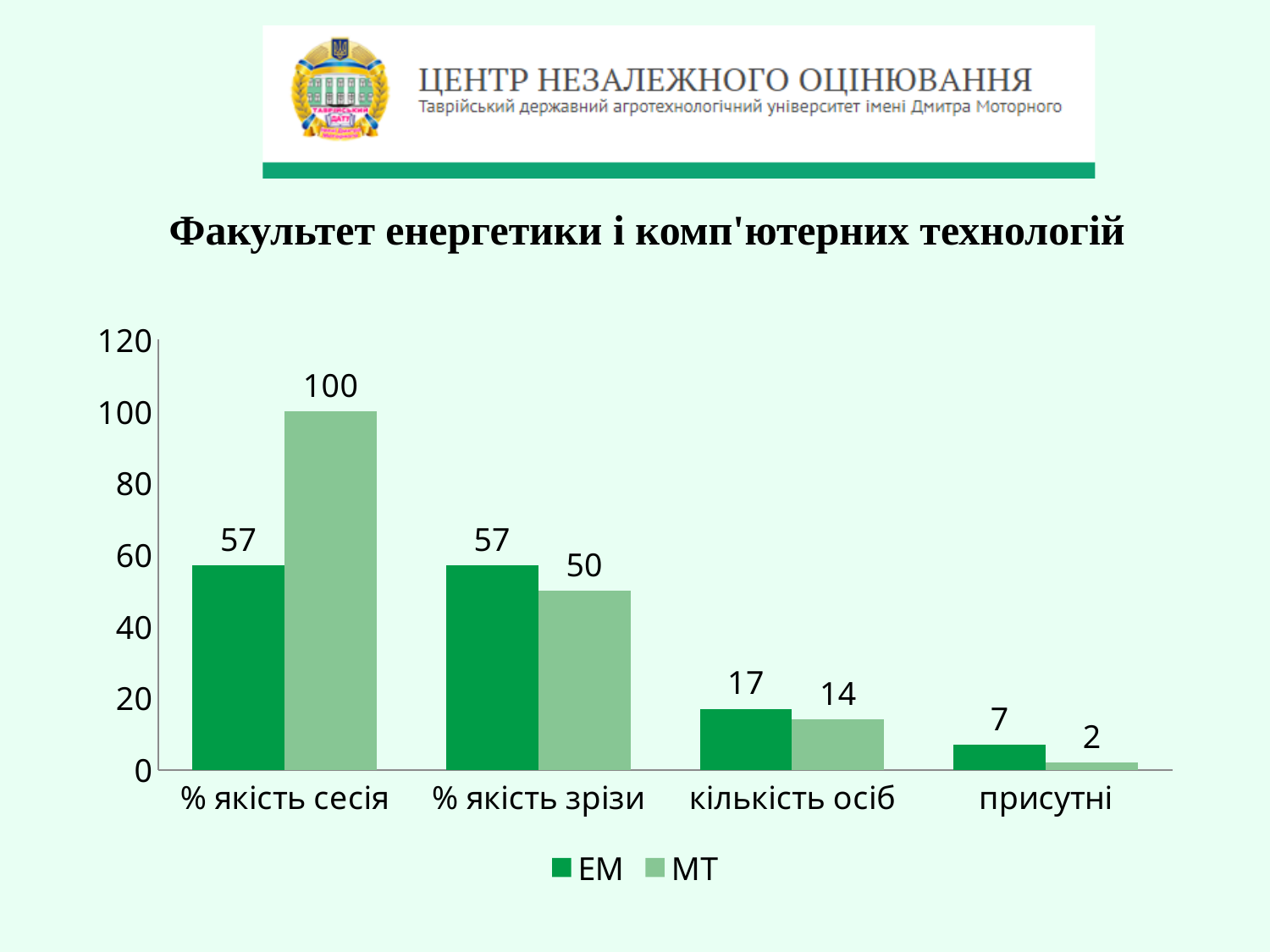
What kind of chart is shown on the slide? bar chart What is the value for МТ in the category "% якість сесія"? 100 What is the value for МТ in the category "присутні"? 2 What is the value for МТ in the category "% якість зрізи"? 50 What is the difference between the МТ and ЕМ values in the category "% якість сесія"? 43 What is the value for ЕМ in the category "кількість осіб"? 17 In the category "кількість осіб", which series has the larger value, ЕМ or МТ? ЕМ Which category has the lowest value for the ЕМ series? присутні Which category has the highest value for the МТ series? % якість сесія How many categories are shown on the x axis? 4 How many series does the legend list? 2 What is the value for ЕМ in the category "% якість сесія"? 57